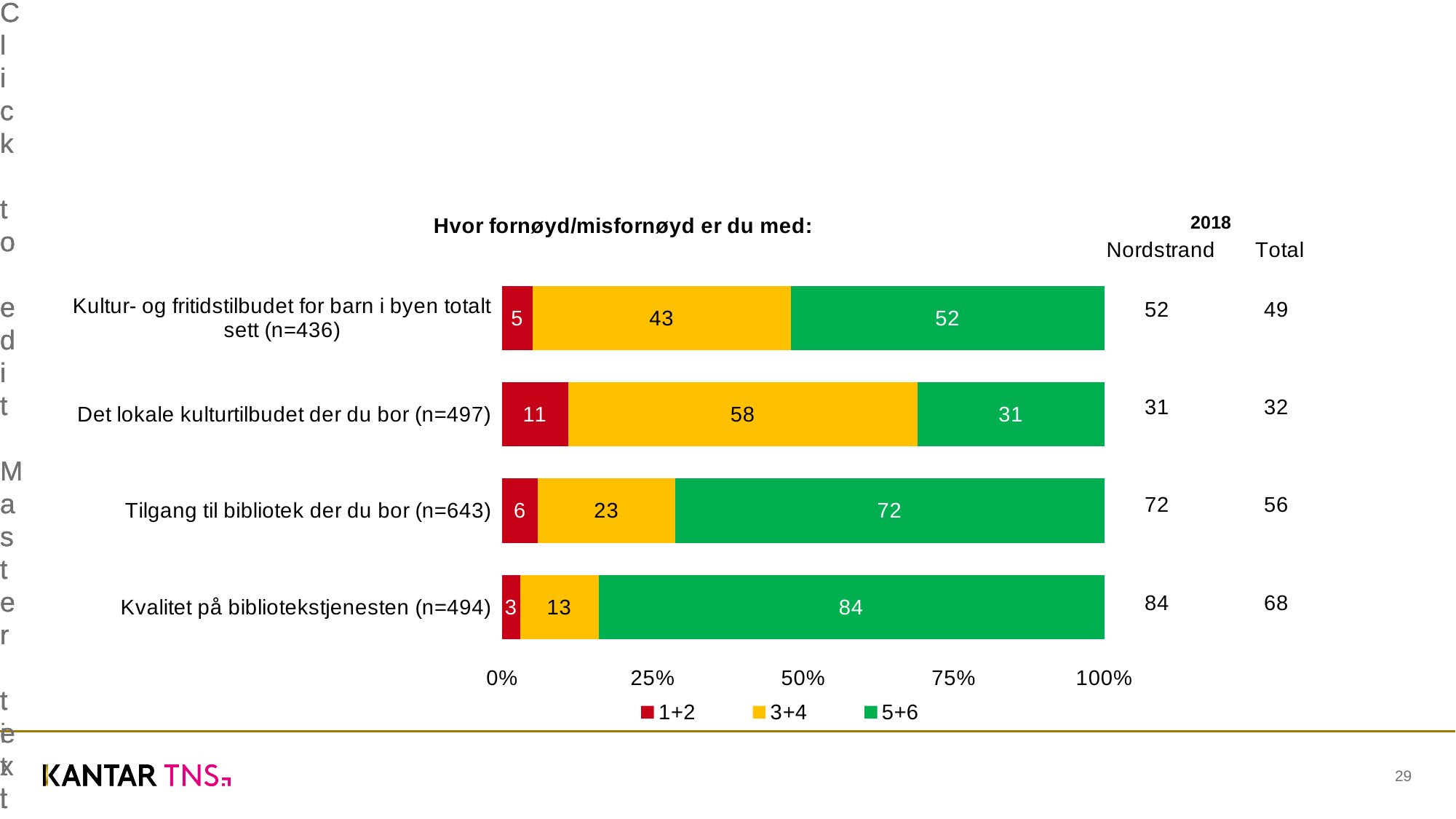
What is the total of the stacked bar for "Det lokale kulturtilbudet der du bor (n=497)"? 100 Which category has the lowest 5+6 value? Det lokale kulturtilbudet der du bor (n=497) Which is larger: the 3+4 value for "Kultur- og fritidstilbudet for barn i byen totalt sett (n=436)" or the 3+4 value for "Tilgang til bibliotek der du bor (n=643)"? Kultur- og fritidstilbudet for barn i byen totalt sett (n=436) What type of chart is shown on the slide? Stacked bar chart What is the title of the chart? Hvor fornøyd/misfornøyd er du med: What is the 3+4 value for "Det lokale kulturtilbudet der du bor (n=497)"? 58 What is the 1+2 value for "Tilgang til bibliotek der du bor (n=643)"? 6 Which category has the highest 5+6 value? Kvalitet på bibliotekstjenesten (n=494) How many series does the legend list? 3 What is the 5+6 value for "Kvalitet på bibliotekstjenesten (n=494)"? 84 What is the difference between the 5+6 values for "Tilgang til bibliotek der du bor (n=643)" and "Kultur- og fritidstilbudet for barn i byen totalt sett (n=436)"? 20 How many categories are plotted in the chart? 4